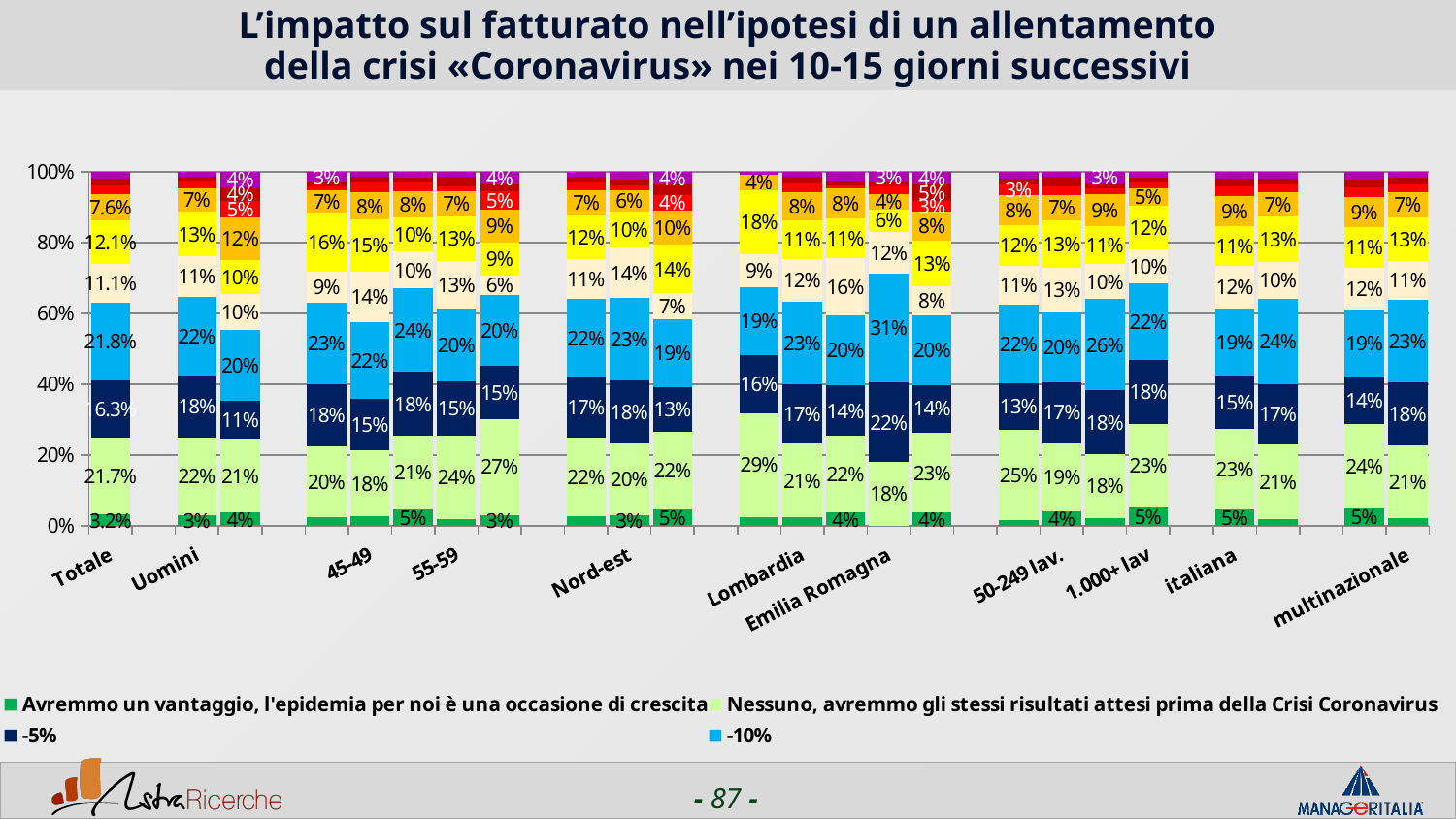
What is the value of the '-5%' segment for 'Lombardia'? 17% What is the value of the 'Nessuno, avremmo gli stessi risultati attesi prima della Crisi Coronavirus' segment for '1.000+ lav'? 23% Which labelled category has the largest '-10%' segment? Emilia Romagna What is the value of the '-10%' segment for the 'Totale' bar? 21.8% How many series are listed in the legend shown on the slide? 4 What is the value of the '-5%' segment for 'Uomini'? 18% What kind of chart is shown on the slide? Stacked bar chart What is the value of the '-10%' segment for 'Emilia Romagna'? 31% Which has the larger '-10%' segment, '45-49' or '55-59'? 45-49 What is the value of the 'Nessuno, avremmo gli stessi risultati attesi prima della Crisi Coronavirus' segment for 'Totale'? 21.7%